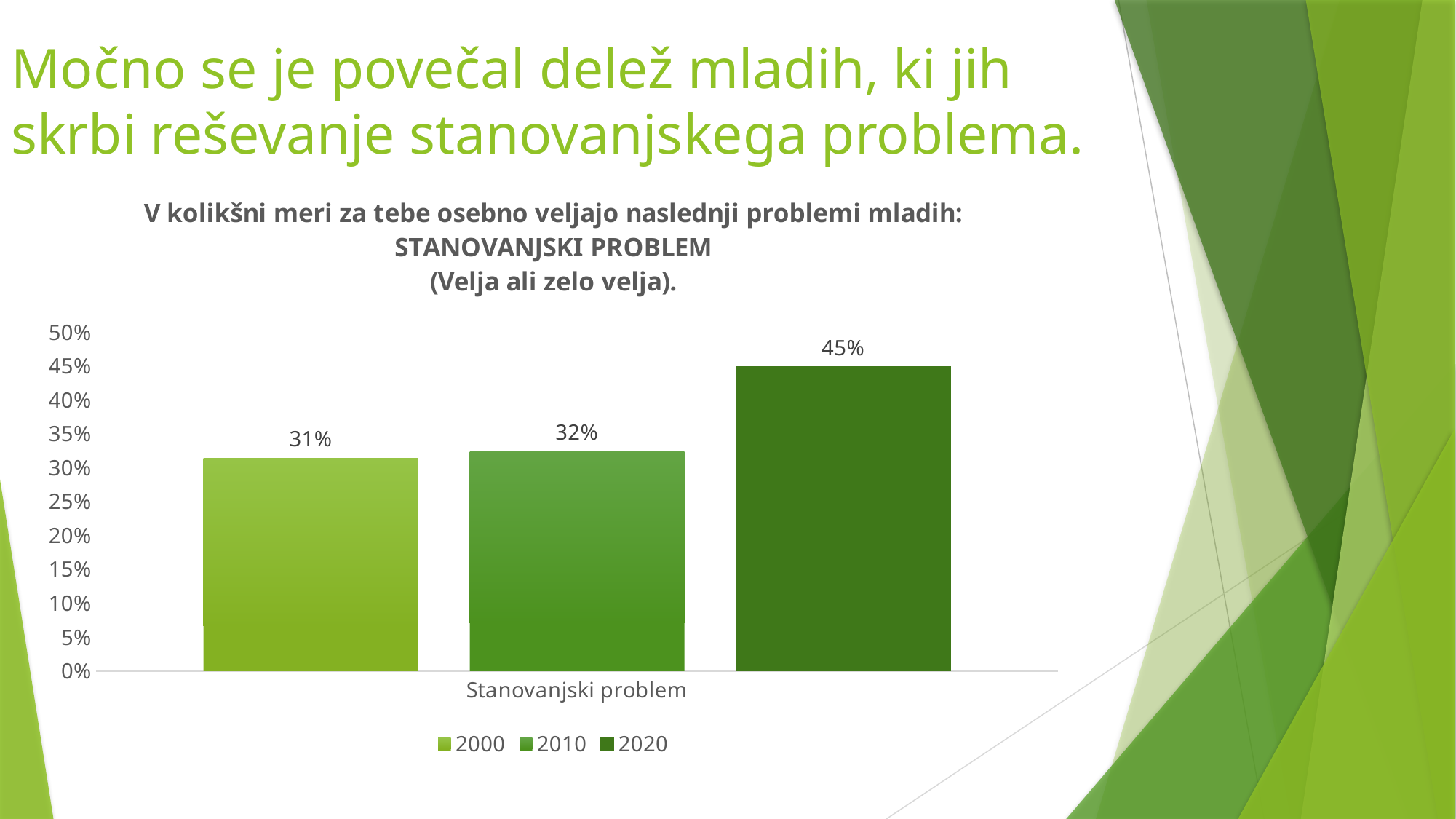
What is the value for 2020 in the chart? 45% What is the difference between the values for 2020 and 2010? 13% Which year has the highest value in the chart? 2020 What kind of chart is shown on the slide? bar chart Is the value for 2020 greater or less than 40%? greater Which is larger, the value for 2020 or the value for 2010? 2020 Which year has the lowest value in the chart? 2000 What is the value for 2010 in the chart? 32% What is the value for 2000 in the chart? 31% How many series does the legend list? 3 What is the category label shown on the x axis of the chart? Stanovanjski problem What is the difference between the values for 2020 and 2000? 14%